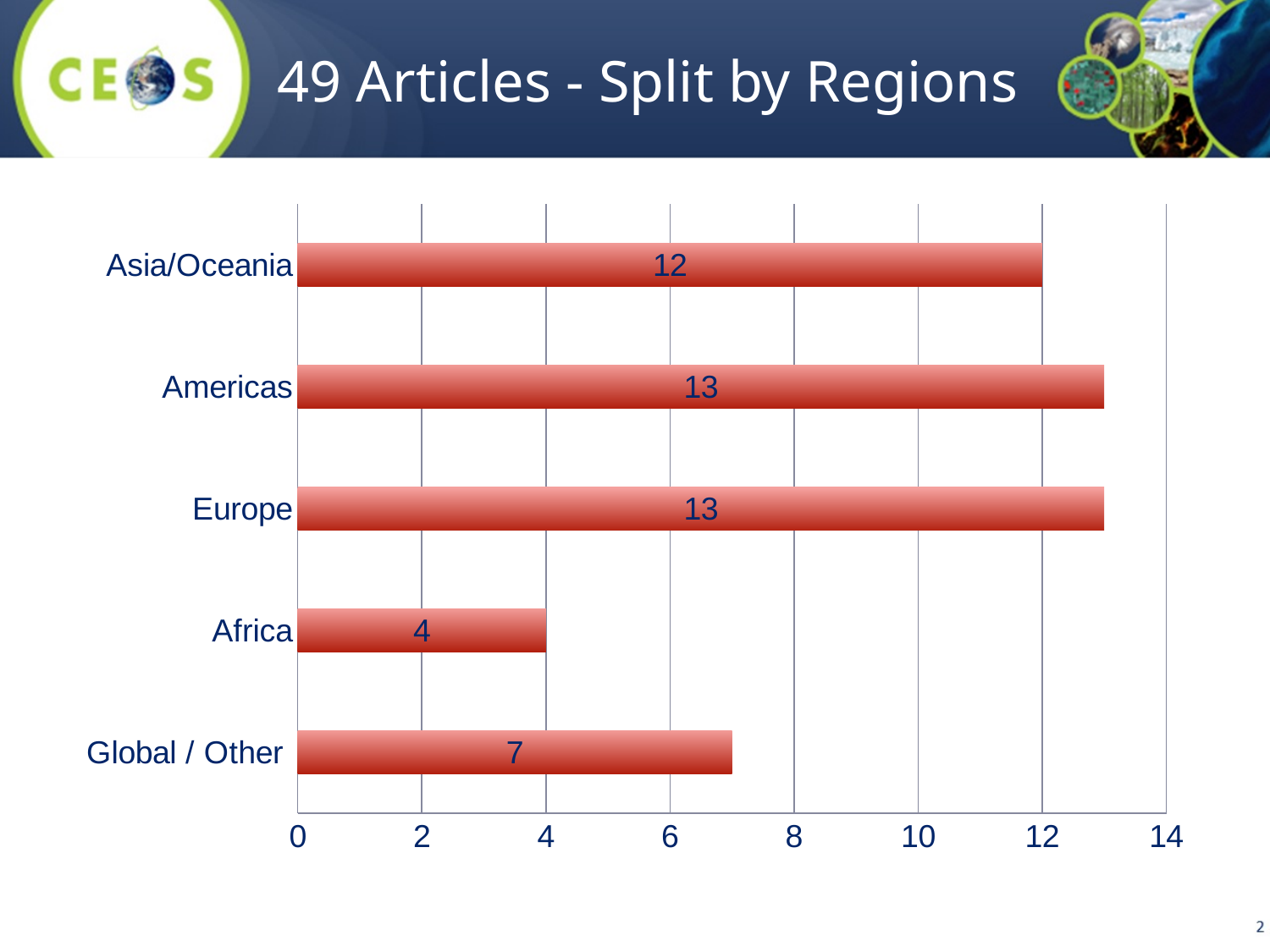
What is the difference between the values for Americas and Africa? 9 Which region has the lowest value? Africa Which is larger, the value for Global / Other or the value for Africa? Global / Other What is the title of the chart? 49 Articles - Split by Regions What is the value for Global / Other? 7 What is the value for Africa? 4 What is the value for Asia/Oceania? 12 What is the value for Europe? 13 What kind of chart is shown on the slide? bar chart What is the difference between the values for Asia/Oceania and Global / Other? 5 How many regions are shown in the chart? 5 Is the value for Americas greater or less than 10? greater